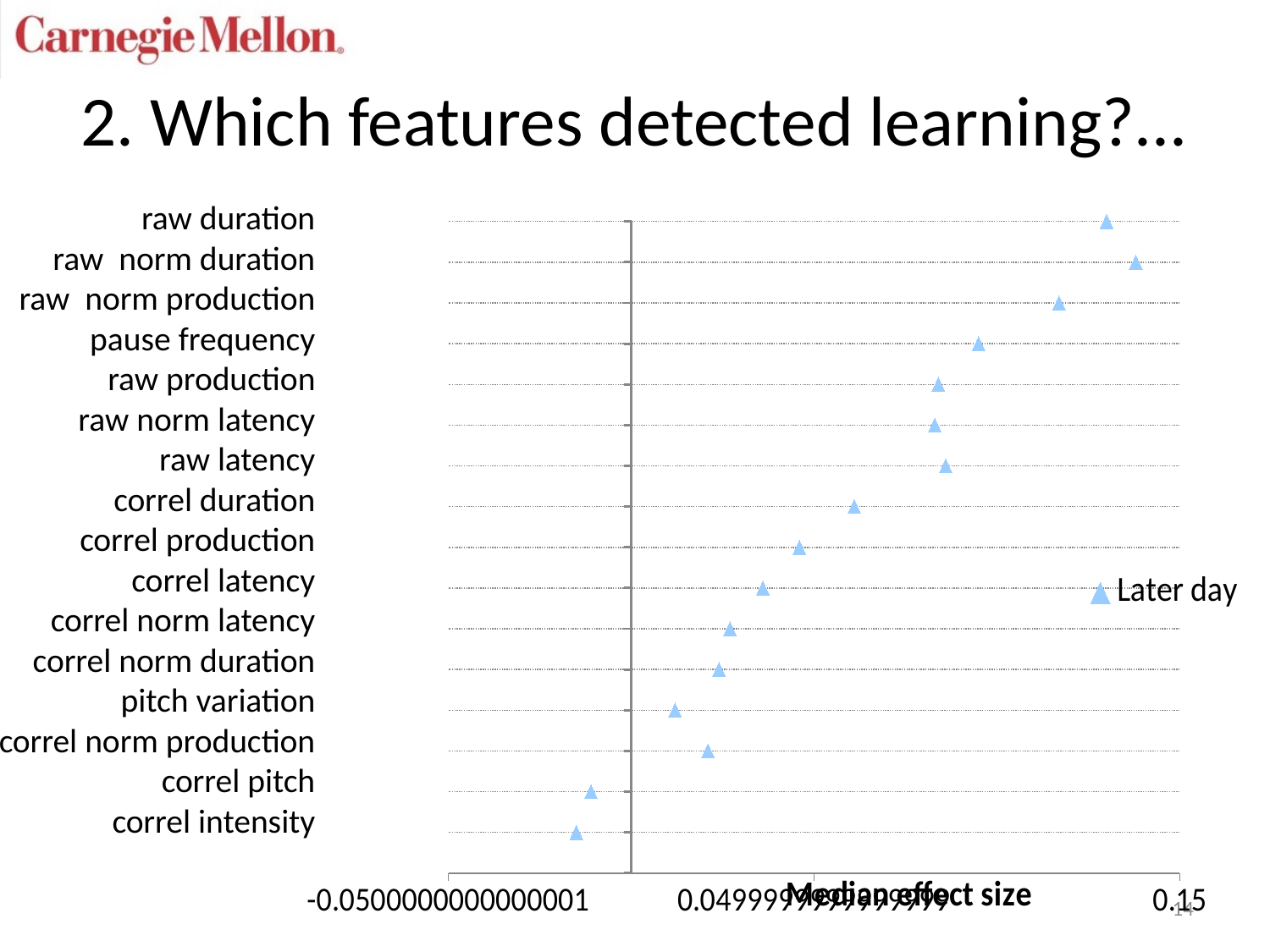
Is the value for correl intensity greater or less than 0? less Is the value for correl pitch greater or less than 0? less Which has the larger median effect size, raw duration or correl intensity? raw duration How many features are listed on the vertical axis of the chart? 16 What is the name of the series shown in the chart legend? Later day How many series does the chart legend list? 1 What kind of chart is shown on the slide? scatter chart Is the value for pitch variation greater or less than 0? greater What is the title of the horizontal axis of the chart? Median effect size Which has the larger median effect size, raw latency or correl norm latency? raw latency